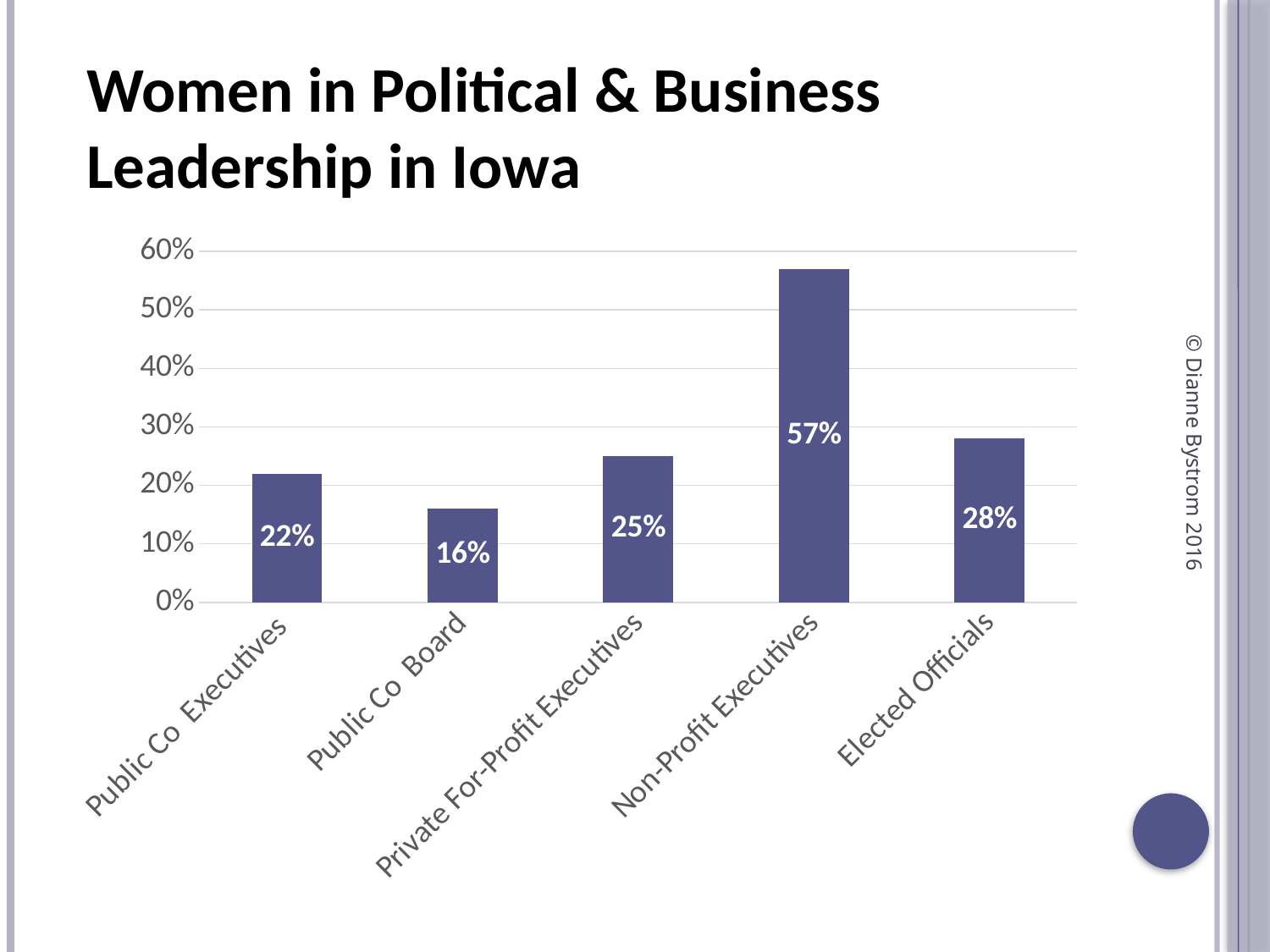
Which category has the highest value? Non-Profit Executives What is the title of the slide containing the chart? Women in Political & Business Leadership in Iowa What kind of chart is shown on the slide? bar chart What is the value for Elected Officials? 28% Which category has the lowest value? Public Co Board What is the value for Non-Profit Executives? 57% How many categories are shown on the chart? 5 Which is larger, the value for Public Co Executives or the value for Private For-Profit Executives? Private For-Profit Executives What is the value for Public Co Board? 16% Is the value for Non-Profit Executives greater or less than 50%? greater What is the difference between the values for Non-Profit Executives and Elected Officials? 29% What is the value for Private For-Profit Executives? 25%